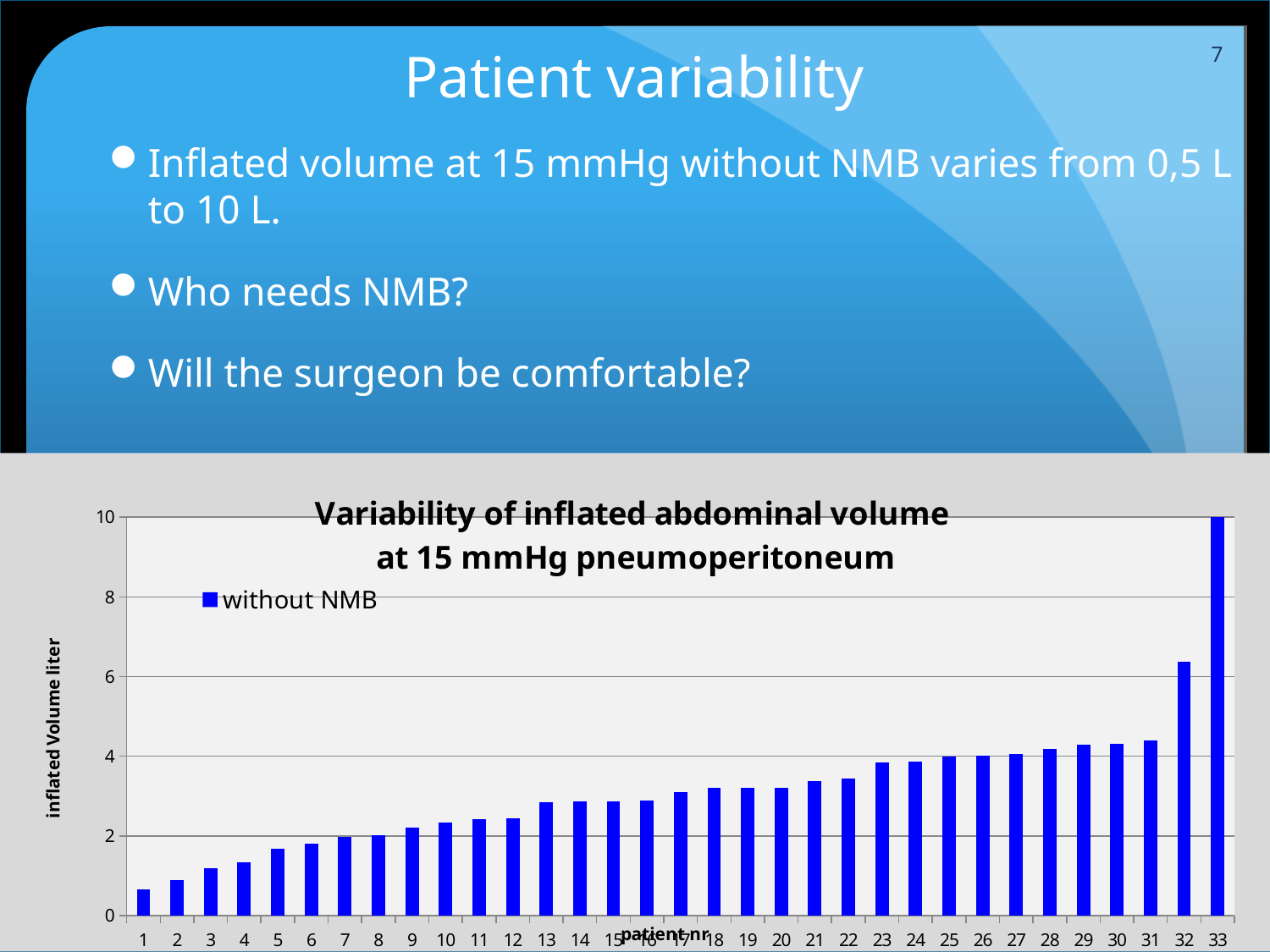
Is the inflated volume for patient 32 greater or less than 6? greater Which has the larger inflated volume, patient 31 or patient 32? patient 32 What is the series name shown in the chart legend? without NMB Which patient number has the highest inflated volume? 33 Do the inflated volume values rise or fall from patient 1 to patient 33? rise Is the inflated volume for patient 20 greater or less than 2? greater Is the inflated volume for patient 1 greater or less than 2? less What kind of chart is shown on the slide? bar chart How many series does the chart legend list? 1 Which patient number has the lowest inflated volume? 1 How many patients are plotted on the x axis of the chart? 33